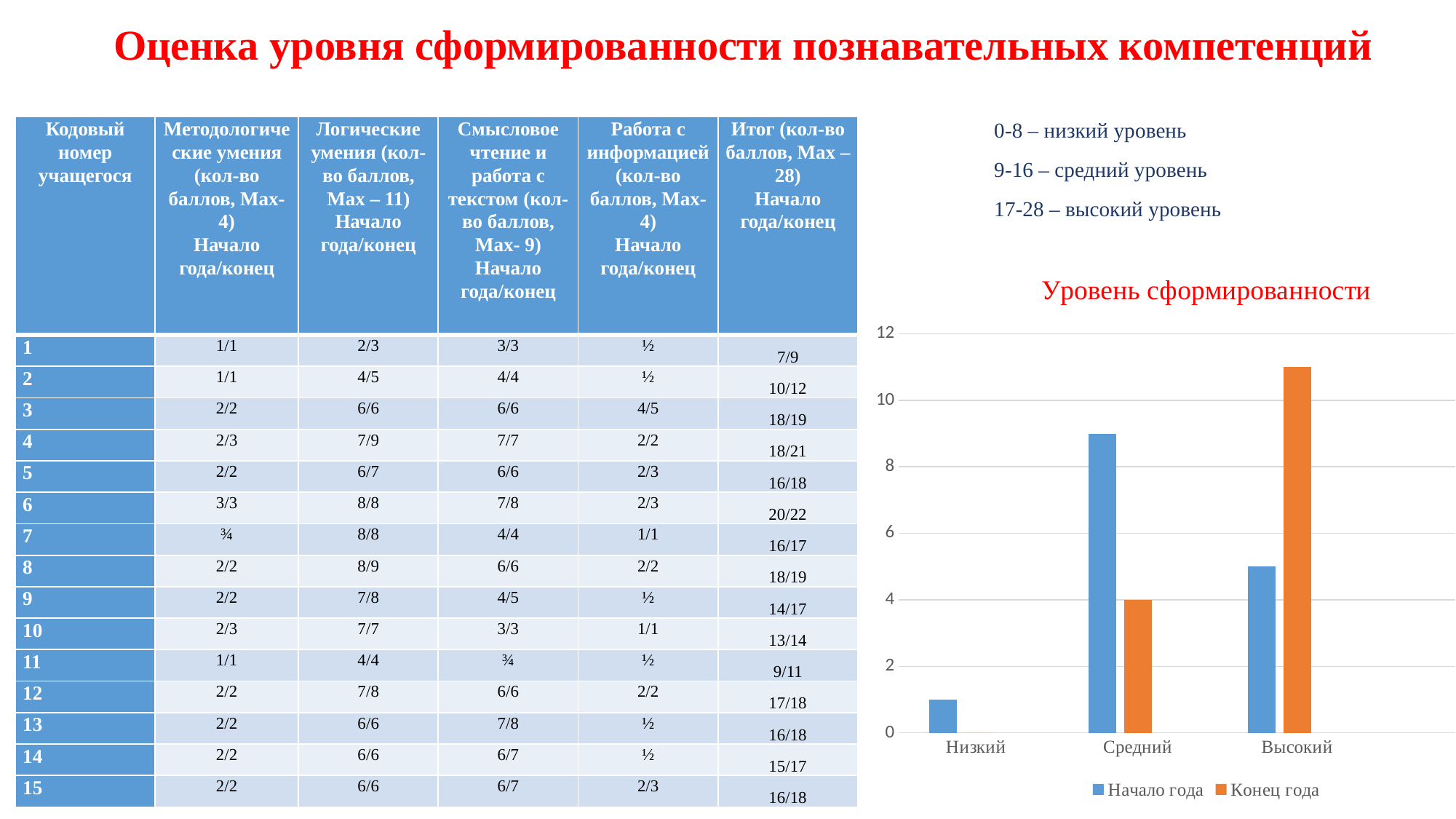
How many series does the legend of the "Уровень сформированности" chart list? 2 What kind of chart is "Уровень сформированности"? bar chart How many categories are shown on the x axis of the "Уровень сформированности" chart? 3 In the "Уровень сформированности" chart, is the value of "Начало года" for "Средний" greater or less than 8? greater In the "Уровень сформированности" chart, is the value of "Конец года" for "Высокий" greater or less than 10? greater In the "Уровень сформированности" chart, which category has the highest "Начало года" value? Средний In the "Уровень сформированности" chart, for "Высокий", which is larger: "Начало года" or "Конец года"? Конец года In the "Уровень сформированности" chart, is the value of "Начало года" for "Высокий" greater or less than 6? less In the "Уровень сформированности" chart, what is the value of "Конец года" for "Средний"? 4 In the "Уровень сформированности" chart, which category has the highest "Конец года" value? Высокий In the "Уровень сформированности" chart, which series is shown in orange? Конец года